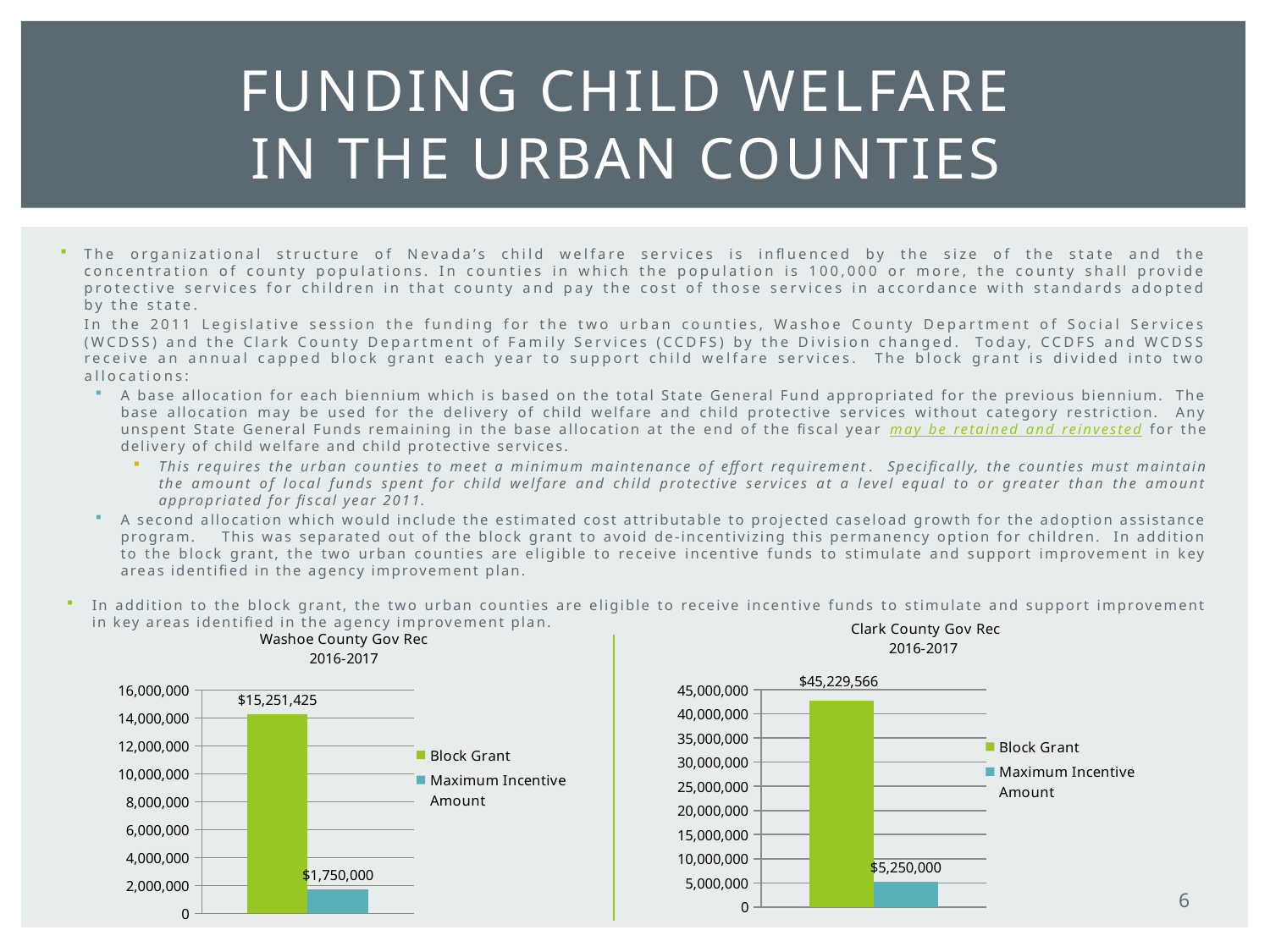
What type of chart is the Washoe County Gov Rec 2016-2017 chart? Bar chart How many series does the legend of the Clark County Gov Rec 2016-2017 chart list? 2 In the Clark County Gov Rec 2016-2017 chart, which series has the highest value? Block Grant In the Washoe County Gov Rec 2016-2017 chart, which series has the lowest value? Maximum Incentive Amount In the Clark County Gov Rec 2016-2017 chart, what is the difference between the Block Grant and the Maximum Incentive Amount? $39,979,566 How much larger is the Clark County Block Grant than the Washoe County Block Grant? $29,978,141 Which county's chart shows the larger Block Grant, Washoe County or Clark County? Clark County In the Clark County Gov Rec 2016-2017 chart, what is the value of the Block Grant? $45,229,566 In the Clark County Gov Rec 2016-2017 chart, what is the Maximum Incentive Amount? $5,250,000 In the Washoe County Gov Rec 2016-2017 chart, what is the value of the Block Grant? $15,251,425 In the Washoe County Gov Rec 2016-2017 chart, what is the Maximum Incentive Amount? $1,750,000 In the Washoe County Gov Rec 2016-2017 chart, what is the difference between the Block Grant and the Maximum Incentive Amount? $13,501,425